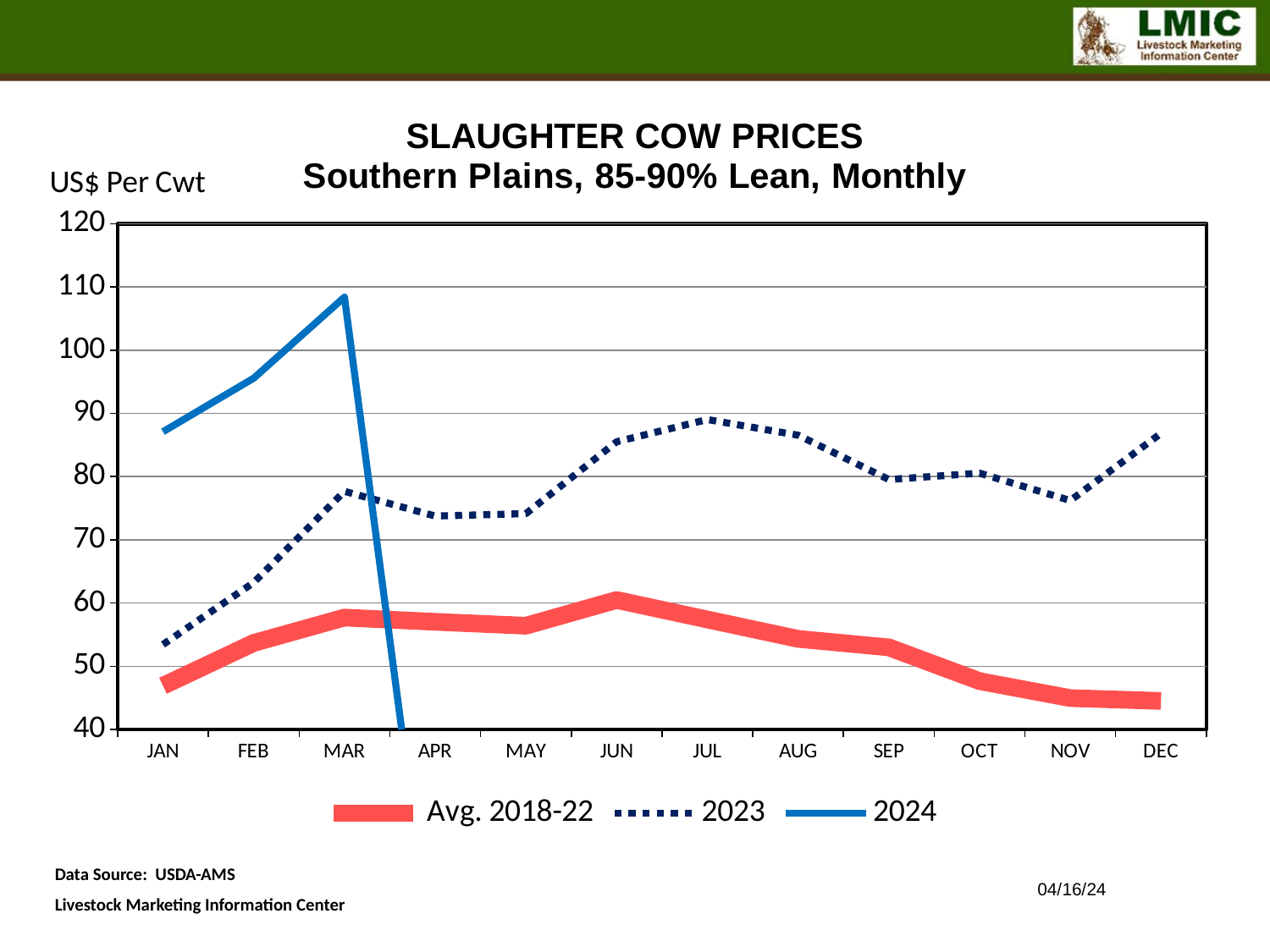
Which month has the highest value for the 2023 series? JUL How many series does the legend list? 3 Is the value for Avg. 2018-22 in JAN greater or less than 50? less Which month has the highest value for the Avg. 2018-22 series? JUN Which month has the lowest value for the 2023 series? JAN Is the value for 2023 in JUL greater or less than 80? greater How many months are shown along the x axis? 12 In MAR, which series has the larger value, 2024 or 2023? 2024 Does the 2024 series rise or fall from JAN to MAR? rise Is the value for 2024 in MAR greater or less than 100? greater What is the unit label shown on the y axis? US$ Per Cwt What kind of chart is shown on the slide? line chart